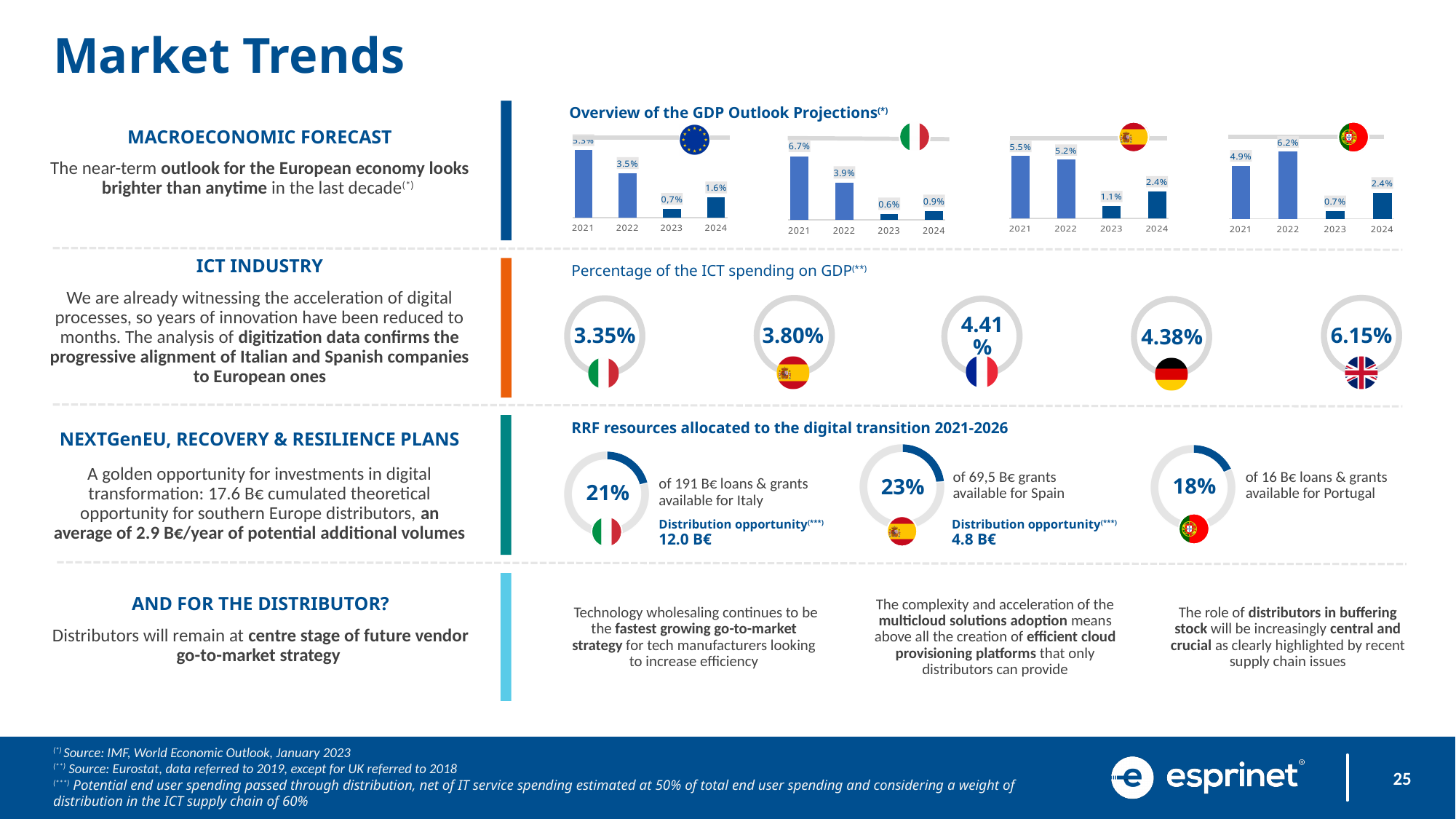
In the GDP Outlook Projections chart for Portugal (rightmost), is the 2021 value or the 2022 value larger? 2022 In the GDP Outlook Projections chart for Italy (second from left), what is the value for 2021? 6.7% In the 'RRF resources allocated to the digital transition 2021-2026' section, what percentage is shown for Spain? 23% In the 'Percentage of the ICT spending on GDP' section, which country has the highest value? UK (6.15%) In the GDP Outlook Projections chart for Italy (second from left), do the values rise or fall from 2021 to 2023? Fall What type of chart is used for the GDP Outlook Projections? Bar chart In the GDP Outlook Projections chart for Spain (third from left), what is the difference between the 2021 and 2024 values? 3.1% How many years are shown in each GDP Outlook Projections bar chart? 4 In the GDP Outlook Projections chart for Spain (third from left), what is the value for 2023? 1.1% In the GDP Outlook Projections chart for Portugal (rightmost), which year has the highest value? 2022 In the GDP Outlook Projections chart for Italy (second from left), which year has the lowest value? 2023 In the GDP Outlook Projections chart for the EU (leftmost), what is the value for 2024? 1.6%